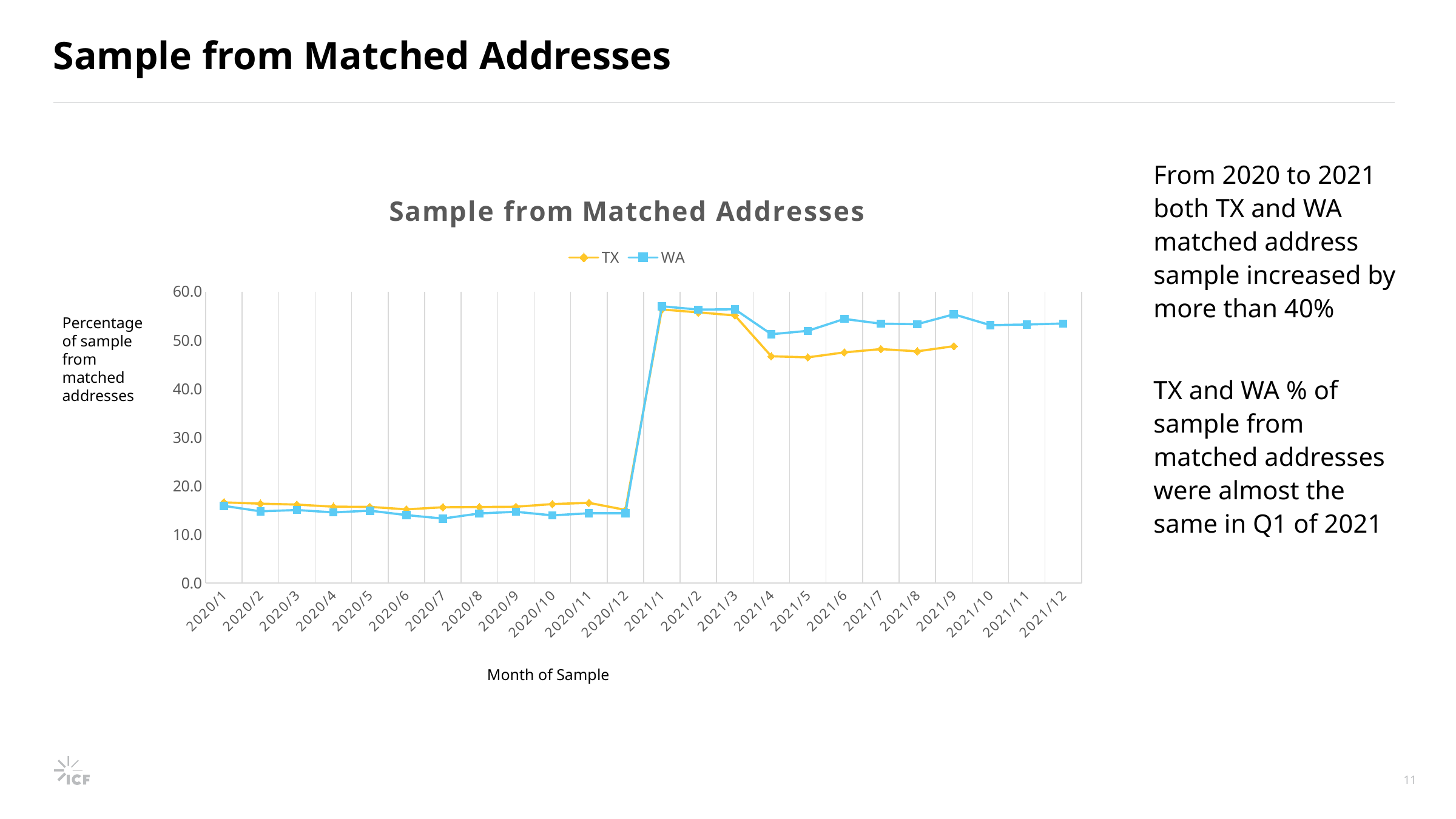
Is the value for TX in 2021/5 greater or less than 50.0? less In 2021/5, which series has the larger value, TX or WA? WA Does the TX line rise or fall from 2020/12 to 2021/1? rise How many series does the legend list? 2 Is the value for TX in 2020/1 greater or less than 20.0? less What is the label of the x axis? Month of Sample What kind of chart is shown on the slide? line chart What is the title of the chart? Sample from Matched Addresses Is the value for WA in 2021/12 greater or less than 50.0? greater In 2021/9, which series has the larger value, TX or WA? WA How many months are shown on the x axis? 24